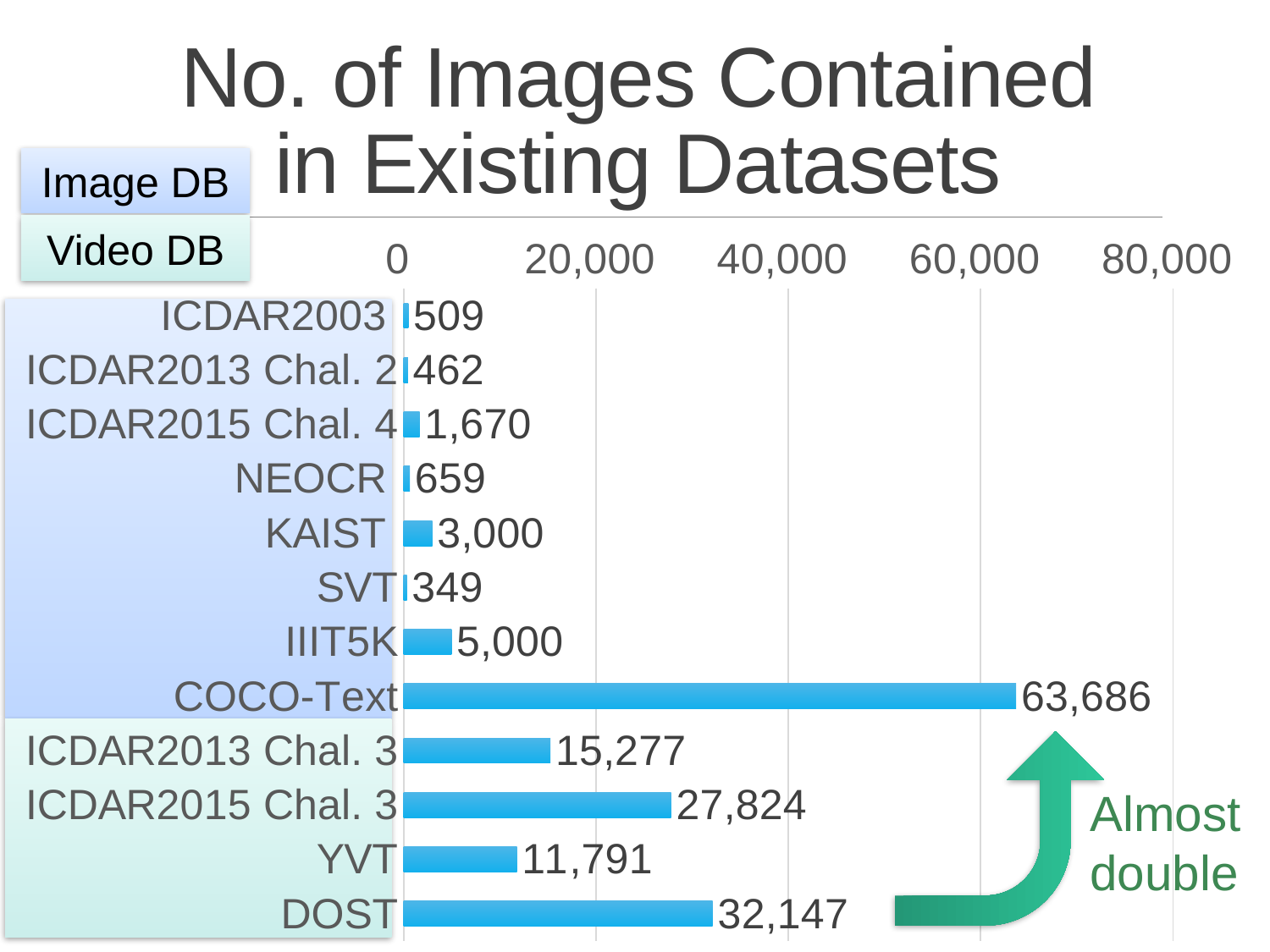
Which dataset has the highest number of images? COCO-Text What is the number of images for COCO-Text? 63,686 What type of chart is shown on the slide? Bar chart How many datasets are shown in the chart? 12 What is the number of images for ICDAR2015 Chal. 3? 27,824 What is the number of images for YVT? 11,791 What is the difference in number of images between DOST and ICDAR2015 Chal. 3? 4,323 What is the difference in number of images between COCO-Text and DOST? 31,539 What is the title of the chart? No. of Images Contained in Existing Datasets Which has more images, ICDAR2013 Chal. 3 or YVT? ICDAR2013 Chal. 3 What is the number of images for DOST? 32,147 Which dataset has the lowest number of images? SVT